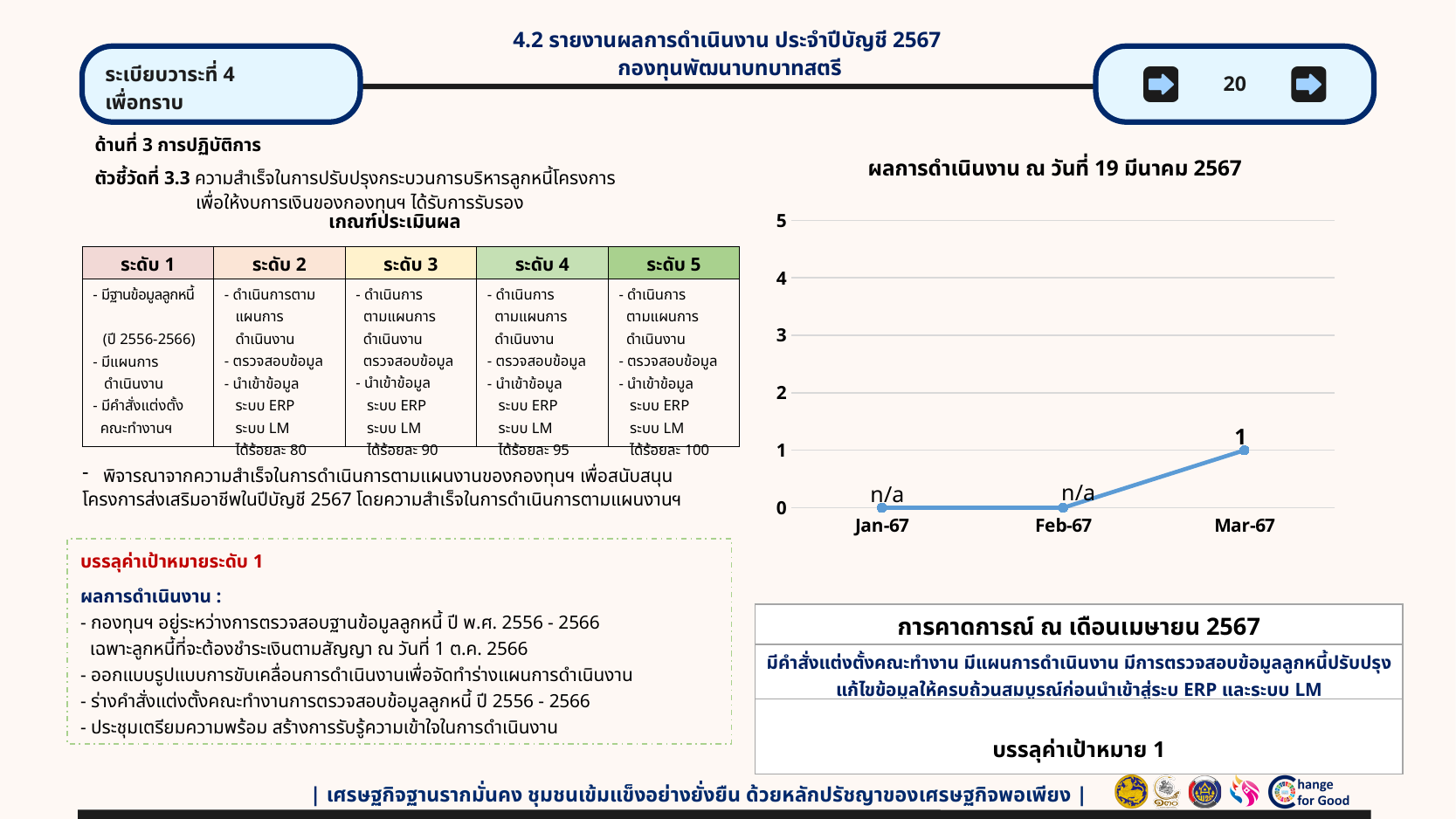
What data label is shown for Feb-67? n/a What is the highest value shown on the y axis? 5 What data label is shown for Jan-67? n/a Is the value for Mar-67 greater or less than 2? less What is the value plotted for Mar-67? 1 Which is larger, the value for Mar-67 or the value for Feb-67? Mar-67 How many points (months) are plotted along the x axis? 3 What is the title of the chart on the slide? ผลการดำเนินงาน ณ วันที่ 19 มีนาคม 2567 What type of chart is shown on the slide? line chart Which month has the highest plotted value? Mar-67 Does the line rise or fall from Feb-67 to Mar-67? rise